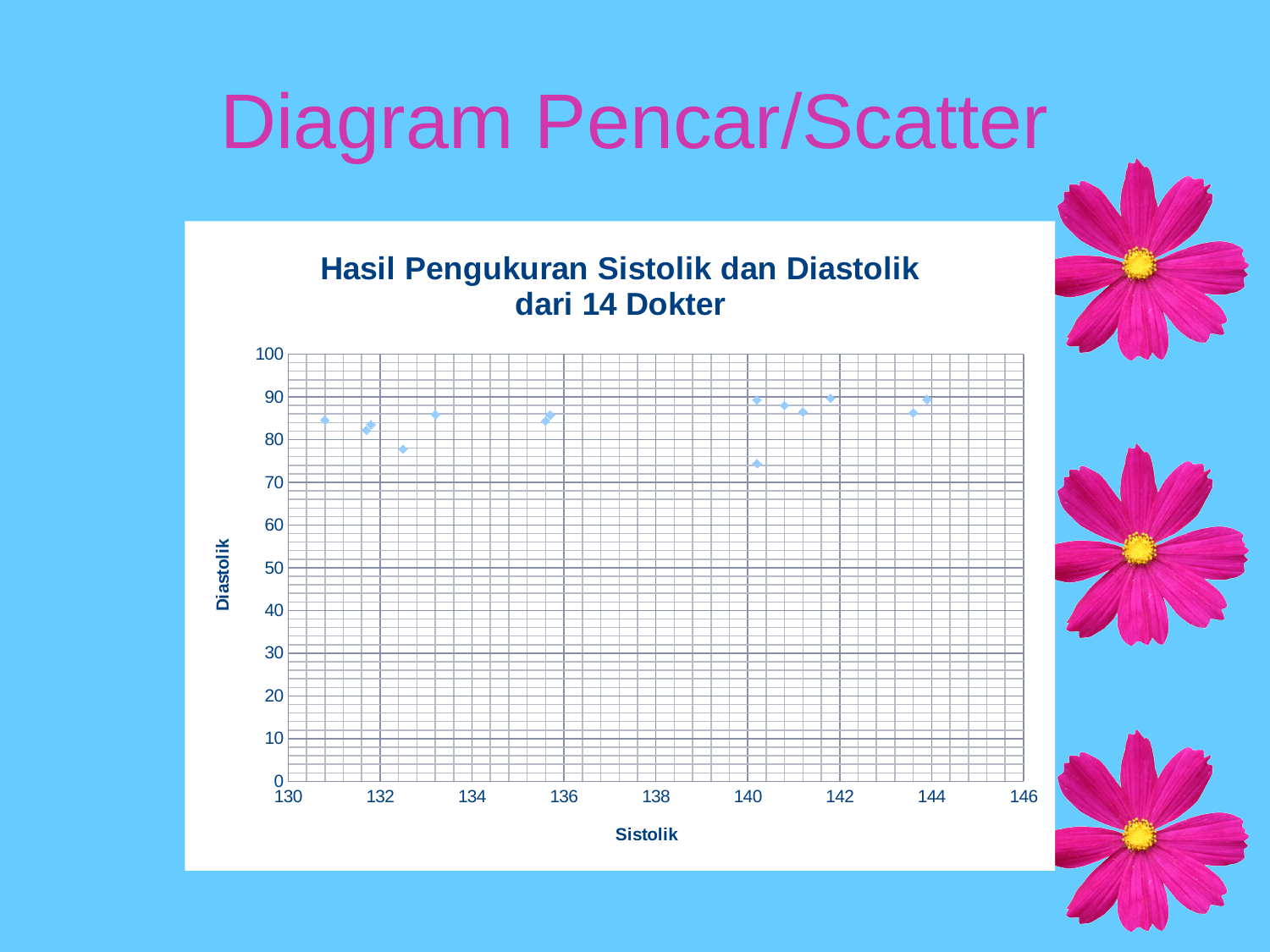
Is the highest Diastolik value plotted on the chart greater or less than 100? less What is the highest value shown on the Sistolik axis? 146 What is the label of the horizontal axis of the chart? Sistolik What is the title of the chart? Hasil Pengukuran Sistolik dan Diastolik dari 14 Dokter How many data points have a Sistolik value between 136 and 140? 0 What kind of chart is shown on the slide? scatter chart Is the lowest Diastolik value plotted on the chart greater or less than 80? less Are all the Diastolik values on the chart greater or less than 50? greater How many data points are plotted on the chart? 14